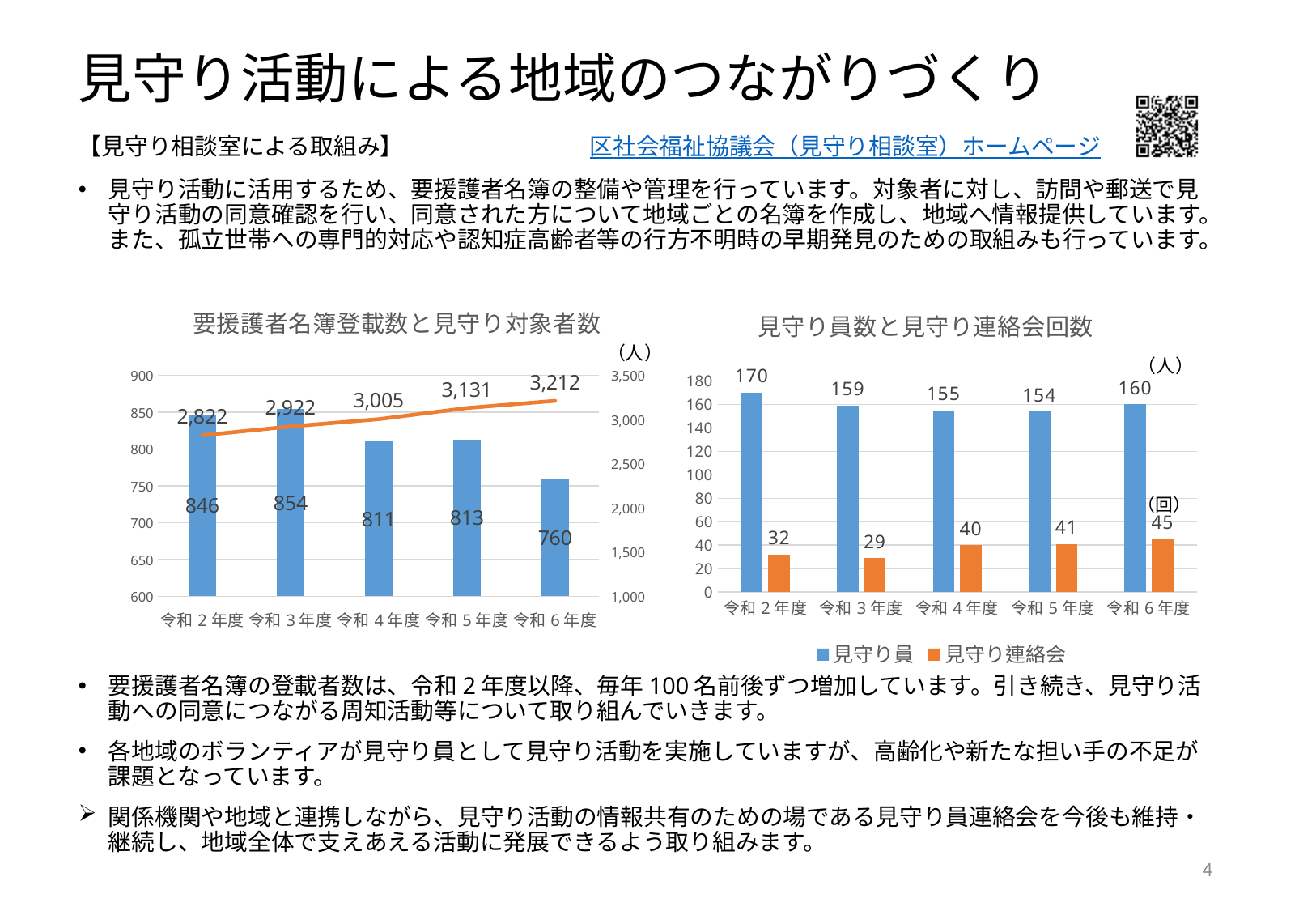
In the chart titled 要援護者名簿登載数と見守り対象者数, what is the difference between the line values for 令和６年度 and 令和２年度? 390 In the chart titled 要援護者名簿登載数と見守り対象者数, does the line rise or fall from 令和２年度 to 令和６年度? rise In the chart titled 要援護者名簿登載数と見守り対象者数, what is the bar value for 令和６年度? 760 What kind of chart is the one titled 見守り員数と見守り連絡会回数? bar chart In the chart titled 見守り員数と見守り連絡会回数, which year has the lowest 見守り連絡会 value? 令和３年度 In the chart titled 見守り員数と見守り連絡会回数, which year has the highest 見守り員 value? 令和２年度 In the chart titled 見守り員数と見守り連絡会回数, what is the difference between the 見守り員 values for 令和２年度 and 令和３年度? 11 In the chart titled 要援護者名簿登載数と見守り対象者数, what is the line value for 令和４年度? 3,005 In the chart titled 見守り員数と見守り連絡会回数, how many series does the legend list? 2 In the chart titled 要援護者名簿登載数と見守り対象者数, which year has the highest bar value? 令和３年度 In the chart titled 見守り員数と見守り連絡会回数, what is the value of 見守り員 for 令和５年度? 154 In the chart titled 見守り員数と見守り連絡会回数, what is the value of 見守り連絡会 for 令和３年度? 29